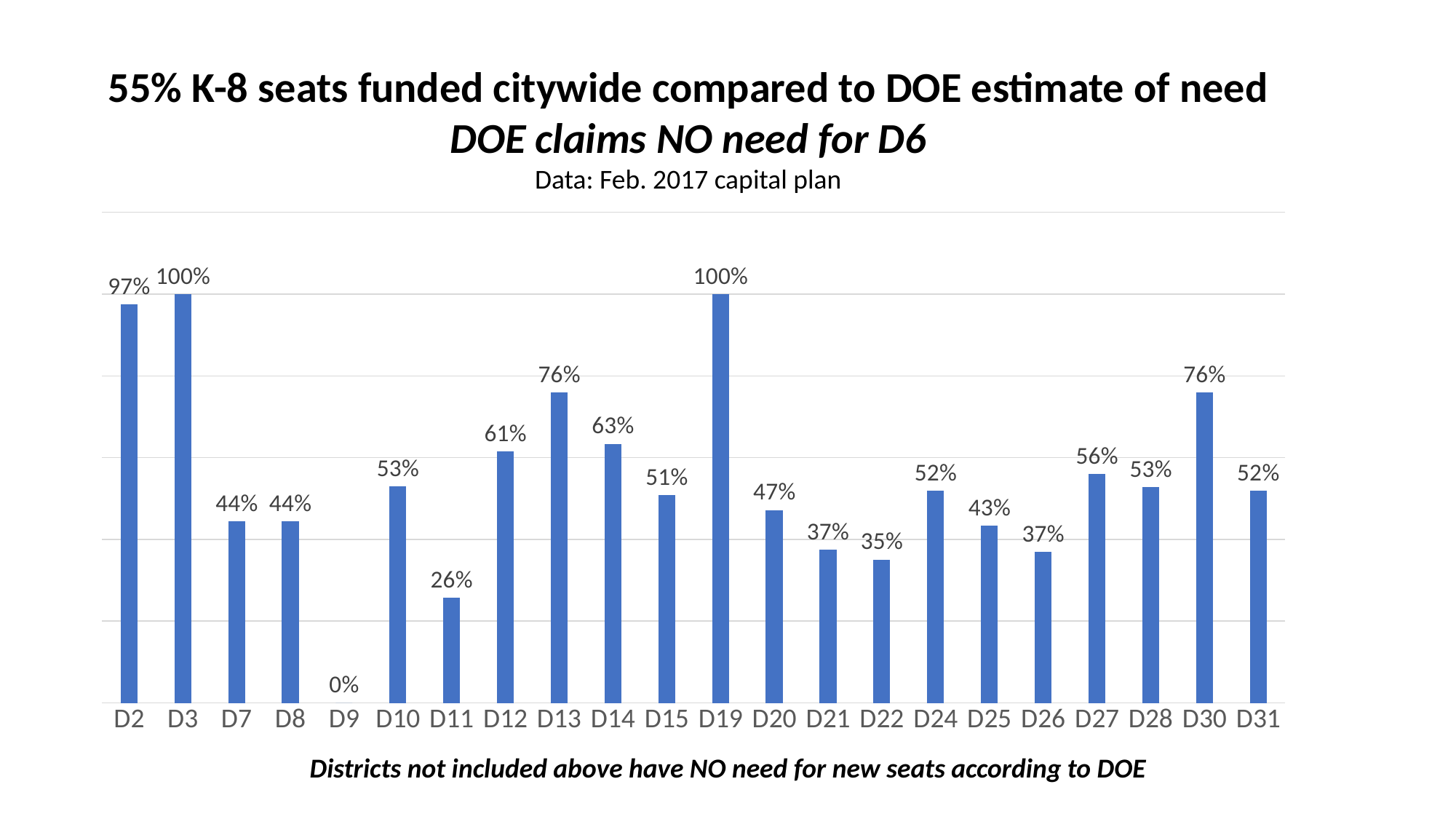
Which is larger, the value for D14 or the value for D27? D14 What is the value for D22? 35% Which is larger, the value for D12 or the value for D25? D12 What is the value for D30? 76% What is the difference between the values for D2 and D20? 50% What is the value for D11? 26% Which districts share the highest value of 100%? D3 and D19 How many districts are shown on the x axis? 22 Which district has the lowest value? D9 What is the difference between the values for D13 and D11? 50% What is the value for D2? 97% What kind of chart is shown on the slide? Bar chart